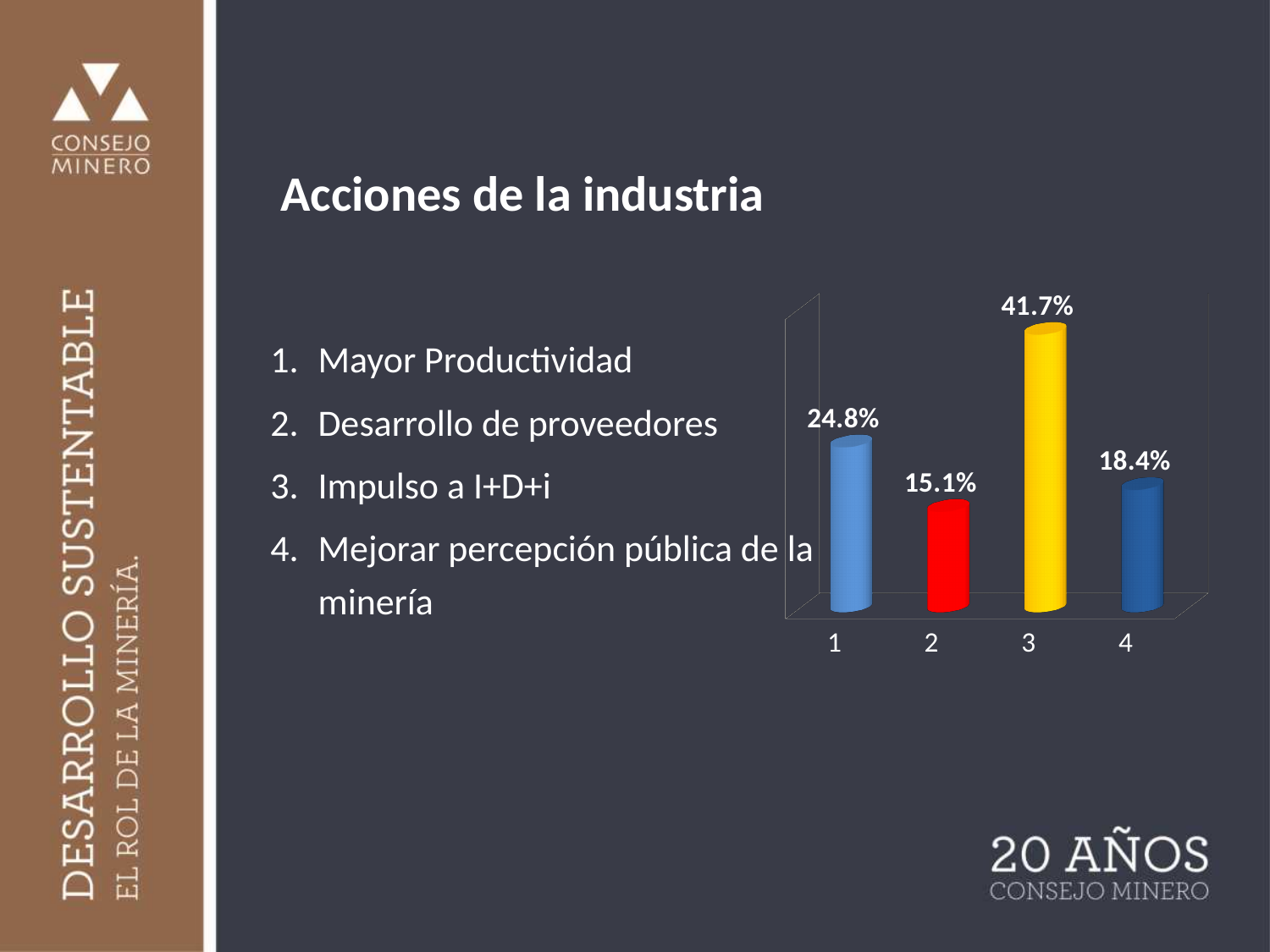
What is the value for category 1 in the chart? 24.8% Which category has the lowest value in the chart? 2 What is the difference between the values for category 3 and category 1? 16.9% What colour is the bar for category 3? yellow What kind of chart is shown on the slide? bar chart What is the value for category 3 in the chart? 41.7% What is the value for category 2 in the chart? 15.1% Which category has the highest value in the chart? 3 What is the difference between the values for category 4 and category 2? 3.3% Which is larger, the value for category 1 or the value for category 4? category 1 What is the value for category 4 in the chart? 18.4% How many categories are shown in the chart? 4